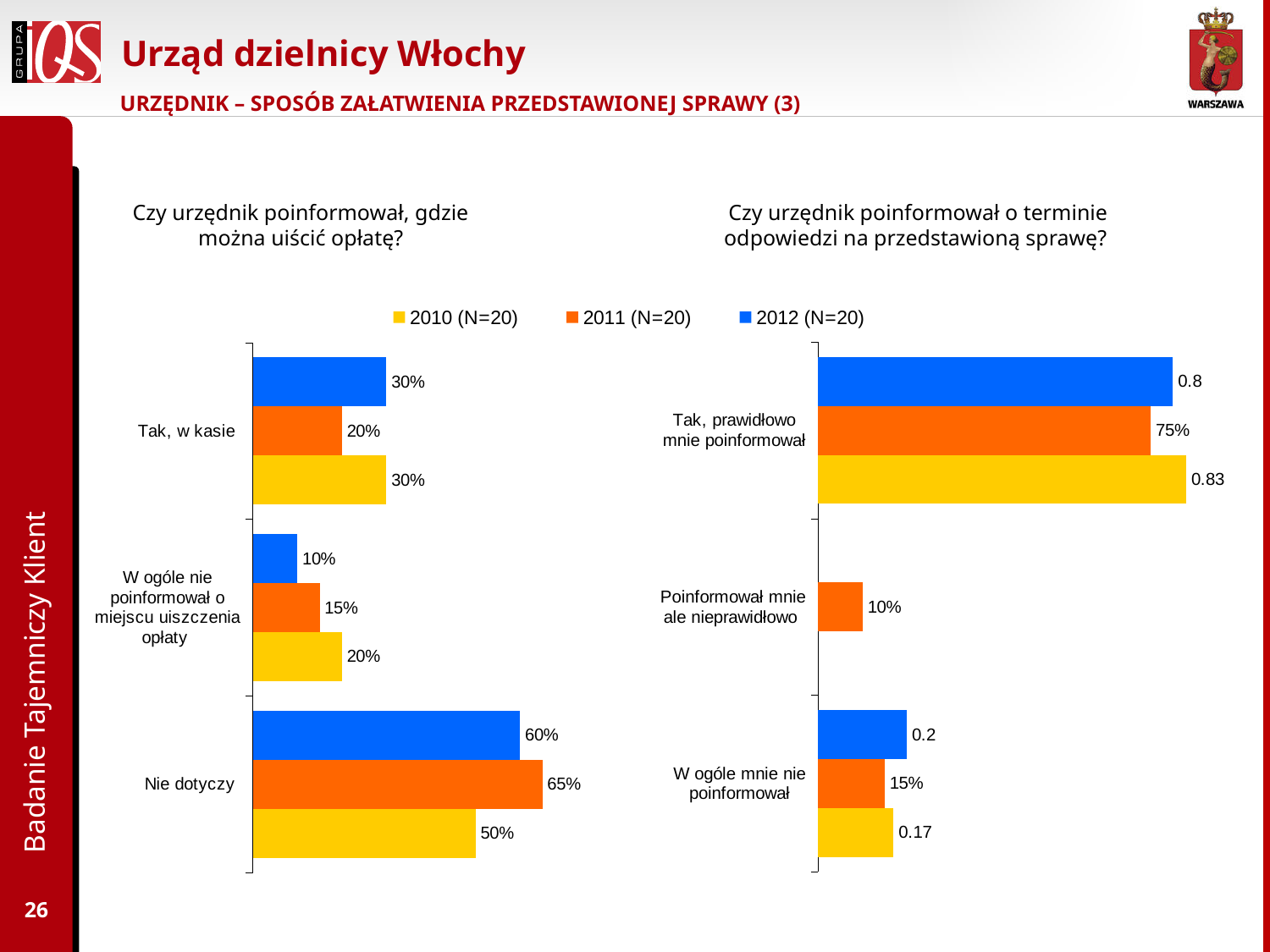
How many series does the legend list? 3 In the right chart (Czy urzędnik poinformował o terminie odpowiedzi na przedstawioną sprawę?), which is larger for 'W ogóle mnie nie poinformował': the 2012 value or the 2011 value? 2012 (N=20) In the left chart (Czy urzędnik poinformował, gdzie można uiścić opłatę?), what is the difference between the 2011 and 2010 values for 'Nie dotyczy'? 15% What type of chart is the right chart (Czy urzędnik poinformował o terminie odpowiedzi na przedstawioną sprawę?)? Bar chart In the left chart (Czy urzędnik poinformował, gdzie można uiścić opłatę?), which category has the highest value for 2012 (N=20)? Nie dotyczy In the left chart (Czy urzędnik poinformował, gdzie można uiścić opłatę?), what is the value for 'Nie dotyczy' in 2011 (N=20)? 65% In the right chart (Czy urzędnik poinformował o terminie odpowiedzi na przedstawioną sprawę?), what is the value for 'W ogóle mnie nie poinformował' in 2010 (N=20)? 0.17 Which colour represents the 2011 (N=20) series in the legend? Orange In the left chart (Czy urzędnik poinformował, gdzie można uiścić opłatę?), which category has the lowest value for 2010 (N=20)? W ogóle nie poinformował o miejscu uiszczenia opłaty In the left chart (Czy urzędnik poinformował, gdzie można uiścić opłatę?), how many categories are shown? 3 In the right chart (Czy urzędnik poinformował o terminie odpowiedzi na przedstawioną sprawę?), what is the value for 'Tak, prawidłowo mnie poinformował' in 2011 (N=20)? 75% In the left chart (Czy urzędnik poinformował, gdzie można uiścić opłatę?), what is the value for 'Tak, w kasie' in 2012 (N=20)? 30%